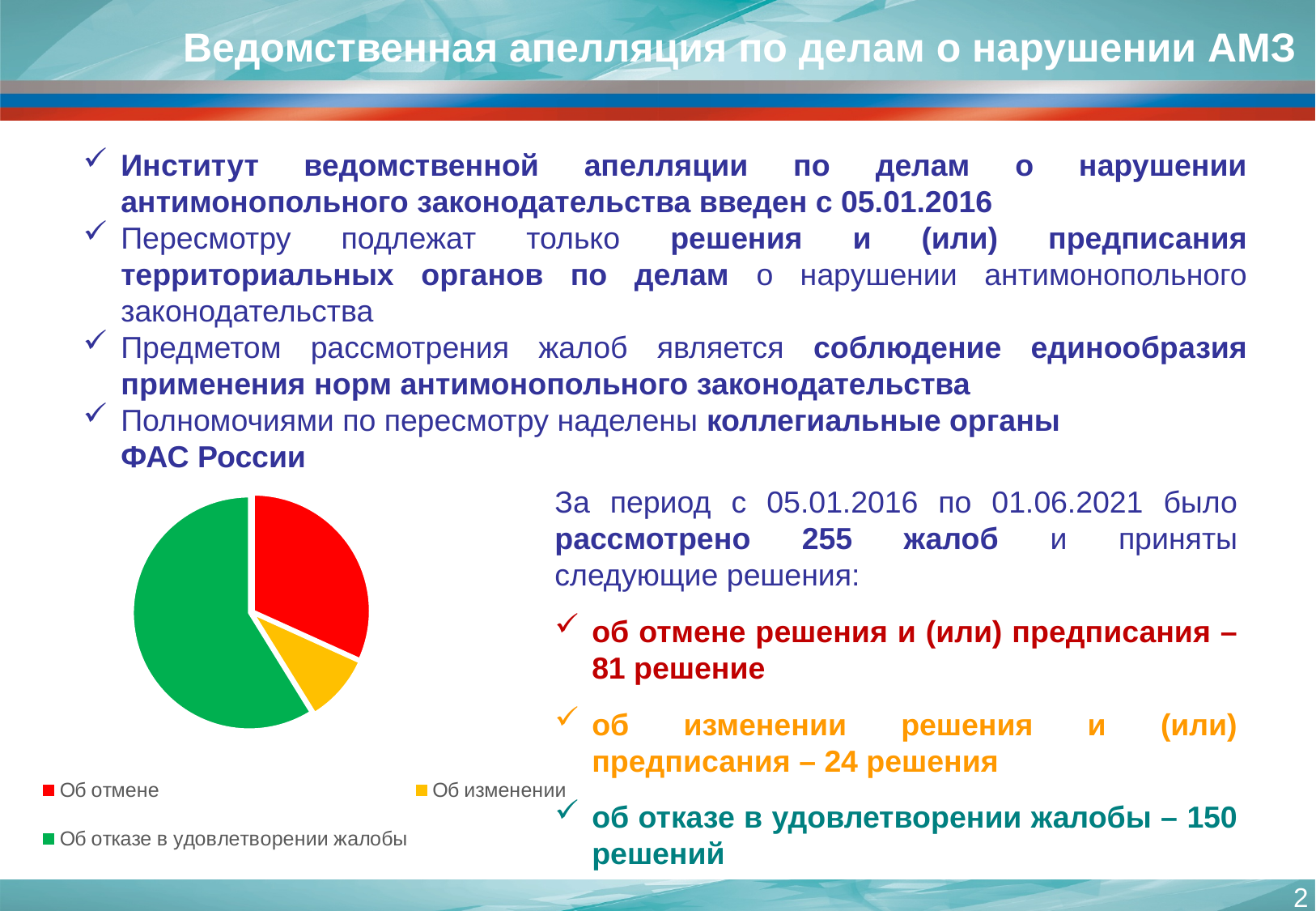
Which category has the largest slice of the pie chart? Об отказе в удовлетворении жалобы According to the slide, how many decisions correspond to the Об изменении slice? 24 According to the slide, how many decisions correspond to the Об отказе в удовлетворении жалобы slice? 150 Which slice is larger: Об отмене or Об изменении? Об отмене Which slice is larger: Об отказе в удовлетворении жалобы or Об отмене? Об отказе в удовлетворении жалобы Which category has the smallest slice of the pie chart? Об изменении What colour is the Об изменении slice in the pie chart? yellow According to the slide, how many decisions correspond to the Об отмене slice? 81 How many slices does the pie chart have? 3 How many entries does the legend of the pie chart list? 3 What is the difference between the number of decisions for Об отказе в удовлетворении жалобы and Об отмене? 69 What kind of chart is shown on the slide? pie chart